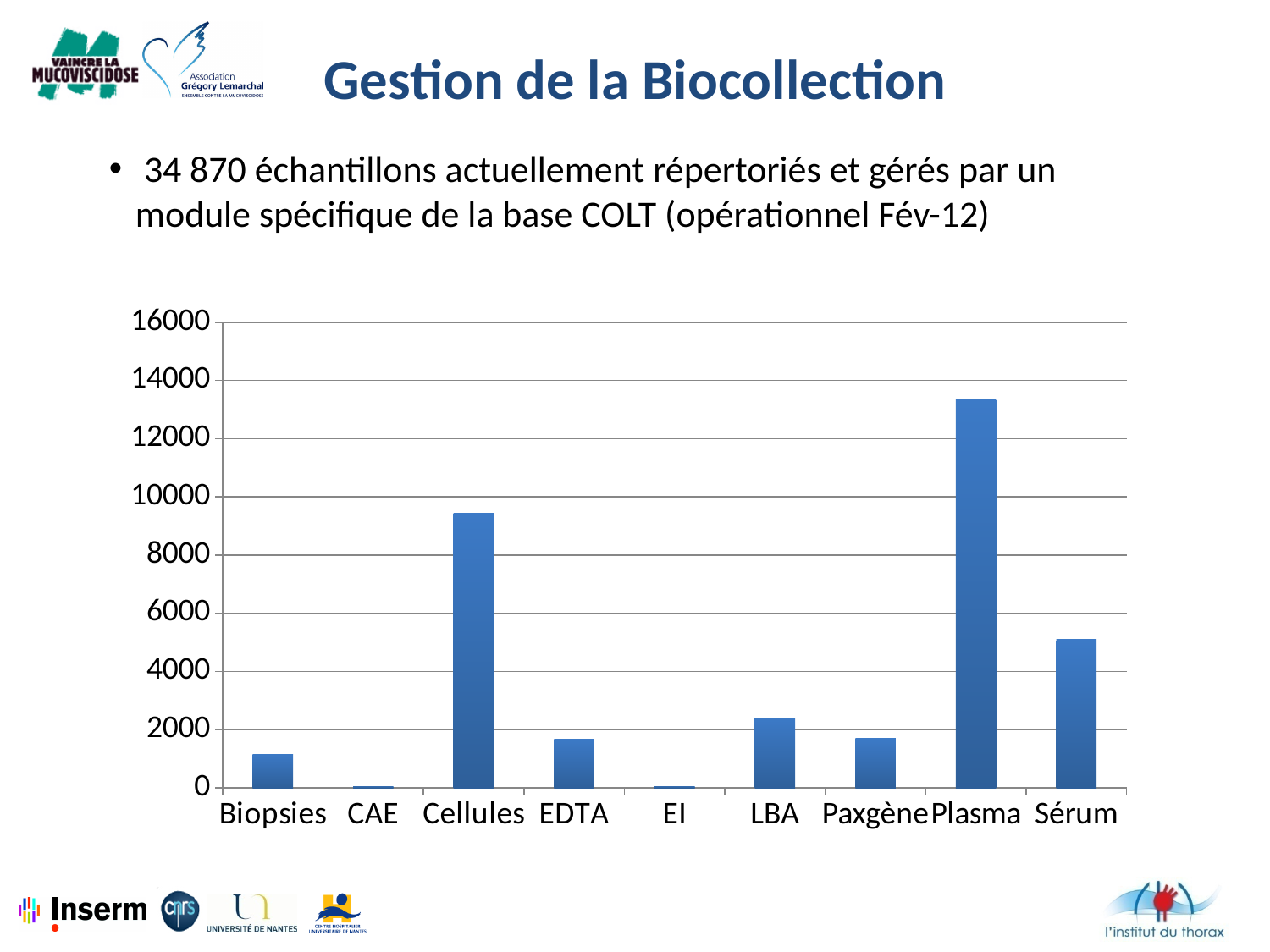
Which is larger, the value for LBA or the value for Biopsies? LBA Which category has the highest bar in the chart? Plasma Is the value for Cellules greater or less than 10000? less Is the value for Biopsies greater or less than 2000? less How many categories are shown on the x axis of the chart? 9 Which is larger, the value for Sérum or the value for Paxgène? Sérum Which is larger, the value for Cellules or the value for Sérum? Cellules Is the value for Plasma greater or less than 12000? greater What kind of chart is shown on the slide? bar chart What is the highest value shown on the y axis of the chart? 16000